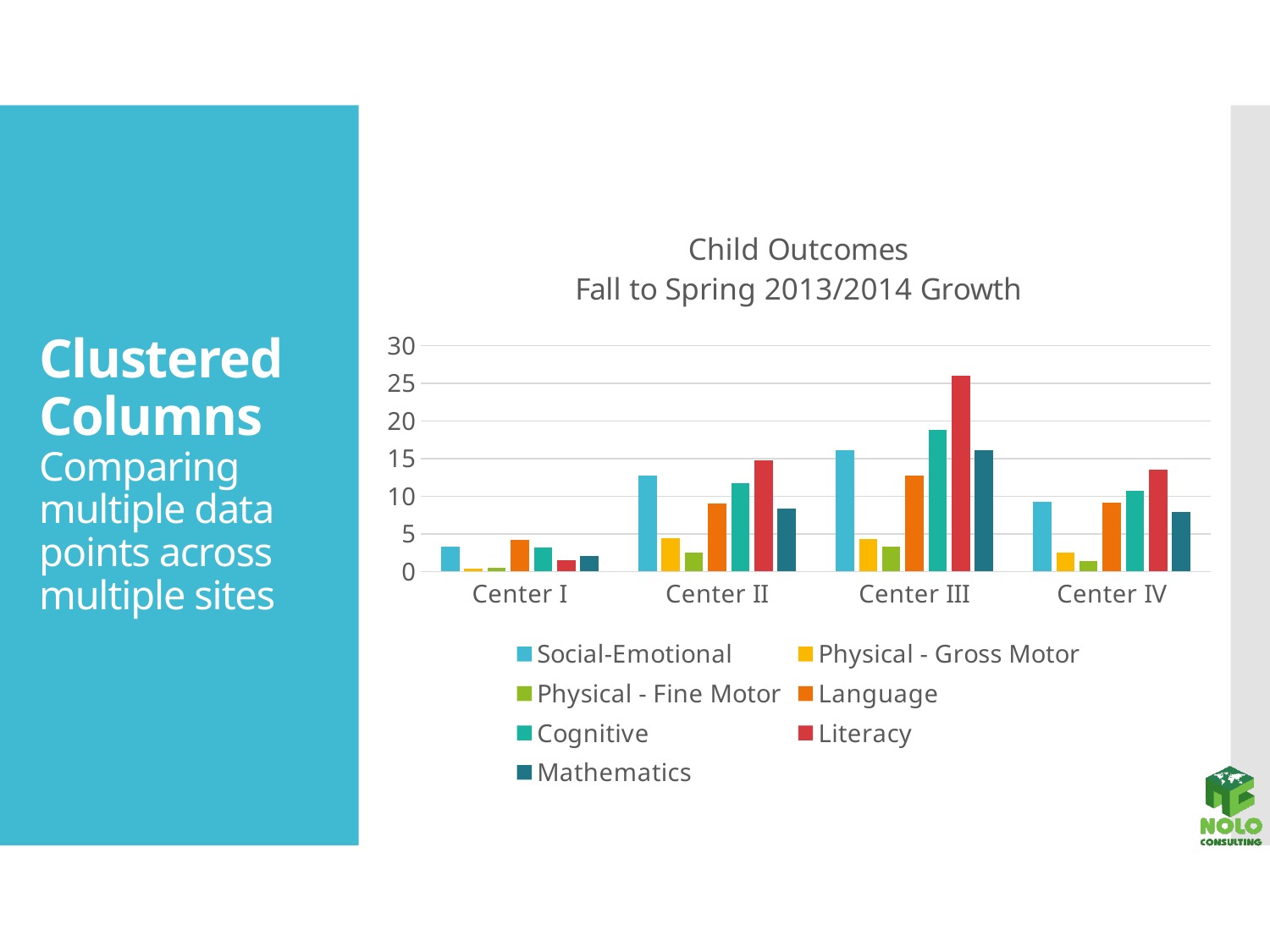
Is the Literacy value for Center III greater or less than 20? greater For Center III, which is larger: Cognitive or Language? Cognitive Is the Mathematics value for Center IV greater or less than 10? less Is the Social-Emotional value for Center II greater or less than 10? greater What is the title of the chart? Child Outcomes Fall to Spring 2013/2014 Growth Which has the larger Literacy value: Center II or Center IV? Center II How many series does the legend list? 7 What kind of chart is shown on the slide? bar chart Which center has the lowest Social-Emotional value? Center I Which center has the highest Literacy value? Center III How many centers are shown on the x axis? 4